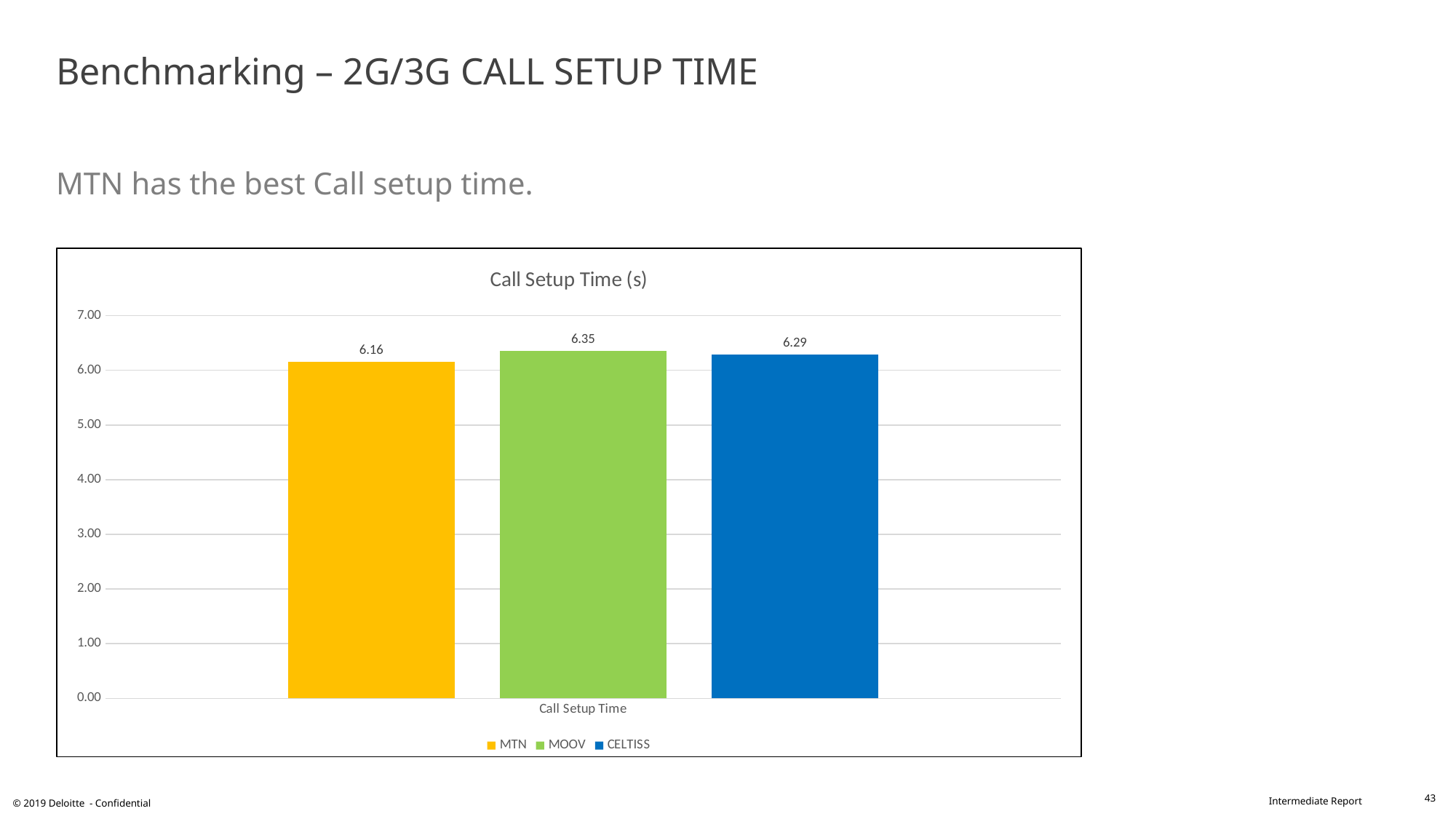
What is the call setup time for MTN? 6.16 What is the difference between the call setup times of CELTISS and MTN? 0.13 Which operator has the highest call setup time? MOOV What is the title of the chart? Call Setup Time (s) Which operator has the lowest call setup time? MTN What kind of chart is shown on the slide? bar chart What is the call setup time for CELTISS? 6.29 Which has a larger call setup time, MOOV or CELTISS? MOOV What is the difference between the call setup times of MOOV and MTN? 0.19 How many series does the legend list? 3 Is the call setup time for MTN greater or less than 6.00? greater What is the call setup time for MOOV? 6.35